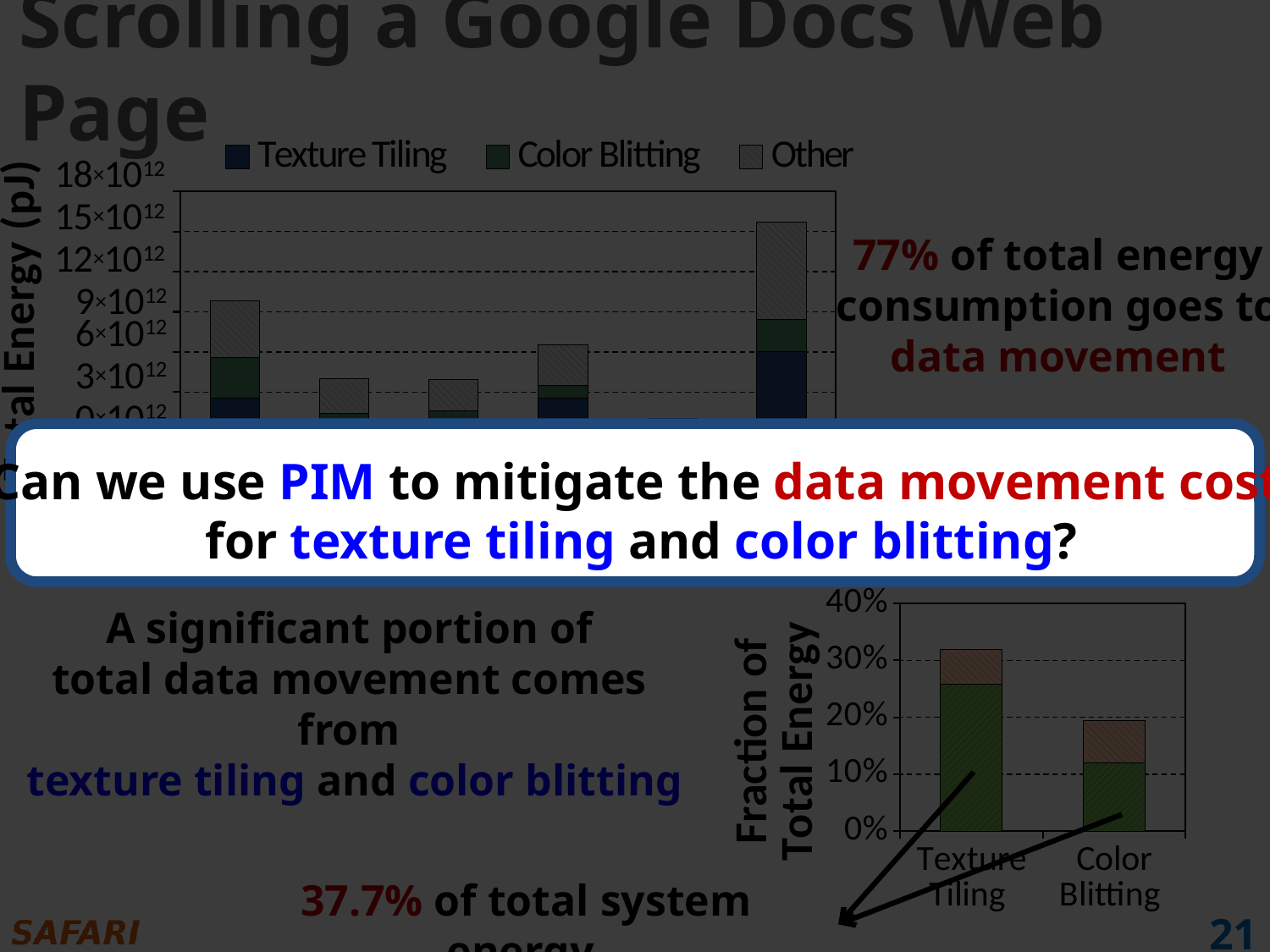
What is the y-axis title of the bottom-right chart? Fraction of Total Energy In the top chart, is the value of the leftmost bar greater or less than 6×10^12? greater In the top chart, is the value of the rightmost bar greater or less than 12×10^12? greater How many categories does the bottom-right chart (Fraction of Total Energy) show? 2 In the bottom-right chart (Fraction of Total Energy), is the value for Texture Tiling greater or less than 20%? greater What kind of chart is the bottom-right chart (Fraction of Total Energy)? bar chart In the bottom-right chart (Fraction of Total Energy), which category has the higher value? Texture Tiling In the top chart, which bar is the tallest, the leftmost or the rightmost? the rightmost What kind of chart is the top chart on the slide? bar chart How many series does the legend of the top chart list? 3 What are the three legend entries of the top chart? Texture Tiling, Color Blitting, Other